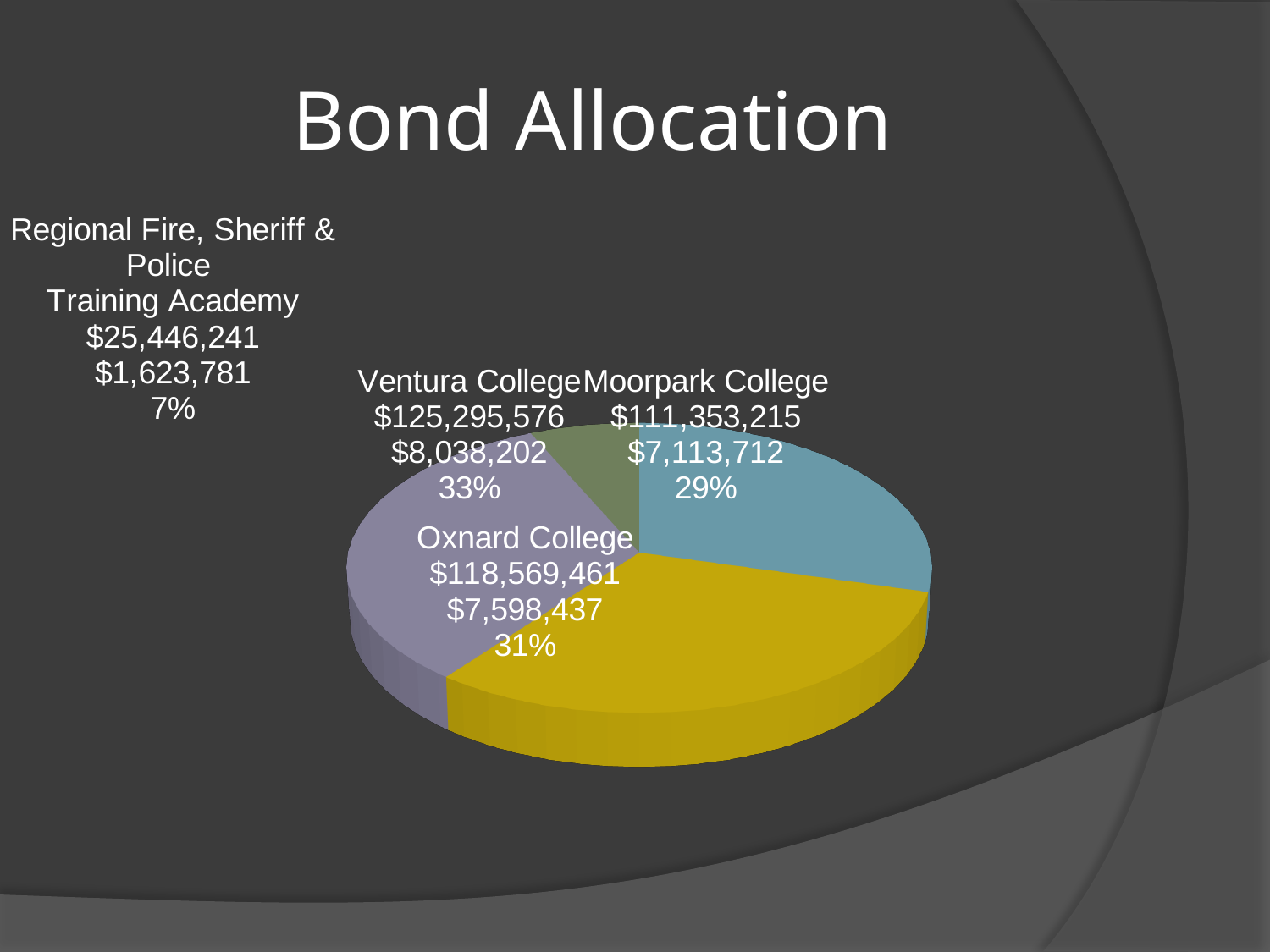
What percentage share of the pie does Oxnard College have? 31% What is the smaller dollar amount shown for Moorpark College? $7,113,712 Which category has the largest share of the pie? Ventura College How many slices does the Bond Allocation pie chart have? 4 Which category has the smallest share of the pie? Regional Fire, Sheriff & Police Training Academy What percentage share of the pie does the Regional Fire, Sheriff & Police Training Academy have? 7% What is the title of the chart? Bond Allocation What is the larger dollar amount shown for Oxnard College? $118,569,461 What kind of chart is shown on the Bond Allocation slide? pie chart What percentage share of the pie does Moorpark College have? 29% What is the larger dollar amount shown for Ventura College? $125,295,576